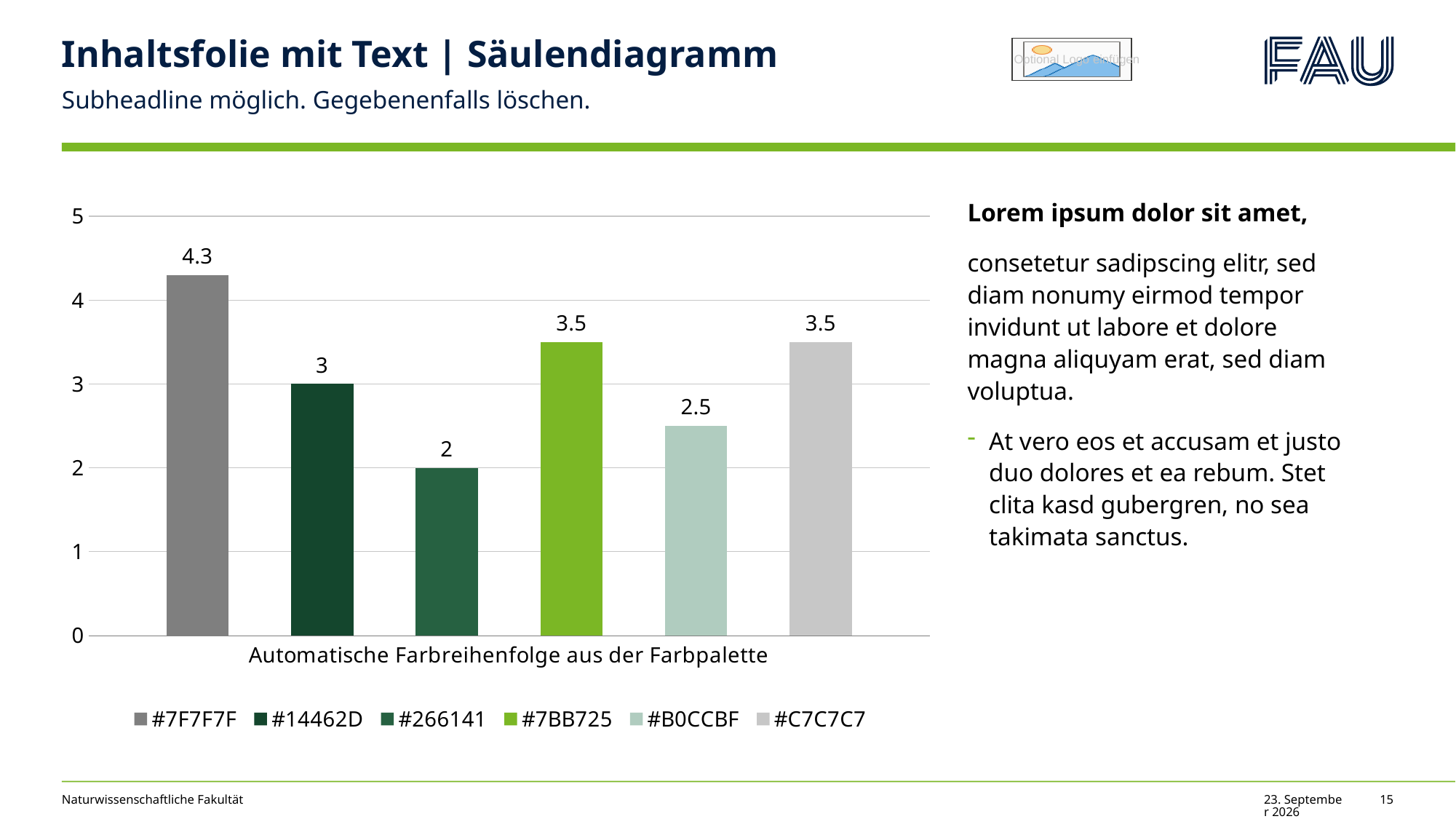
What is the value for the #266141 series? 2 How many bars are plotted in the chart? 6 Which is larger, the value for #14462D or the value for #B0CCBF? #14462D Which series has the lowest value? #266141 What is the category label shown below the bars on the x axis? Automatische Farbreihenfolge aus der Farbpalette How many series does the legend list? 6 Is the value for #7BB725 greater or less than 3? greater What is the difference between the values for #7F7F7F and #14462D? 1.3 What is the value for the #7F7F7F series? 4.3 Which series has the highest value? #7F7F7F What kind of chart is shown on the slide? bar chart What is the value for the #B0CCBF series? 2.5